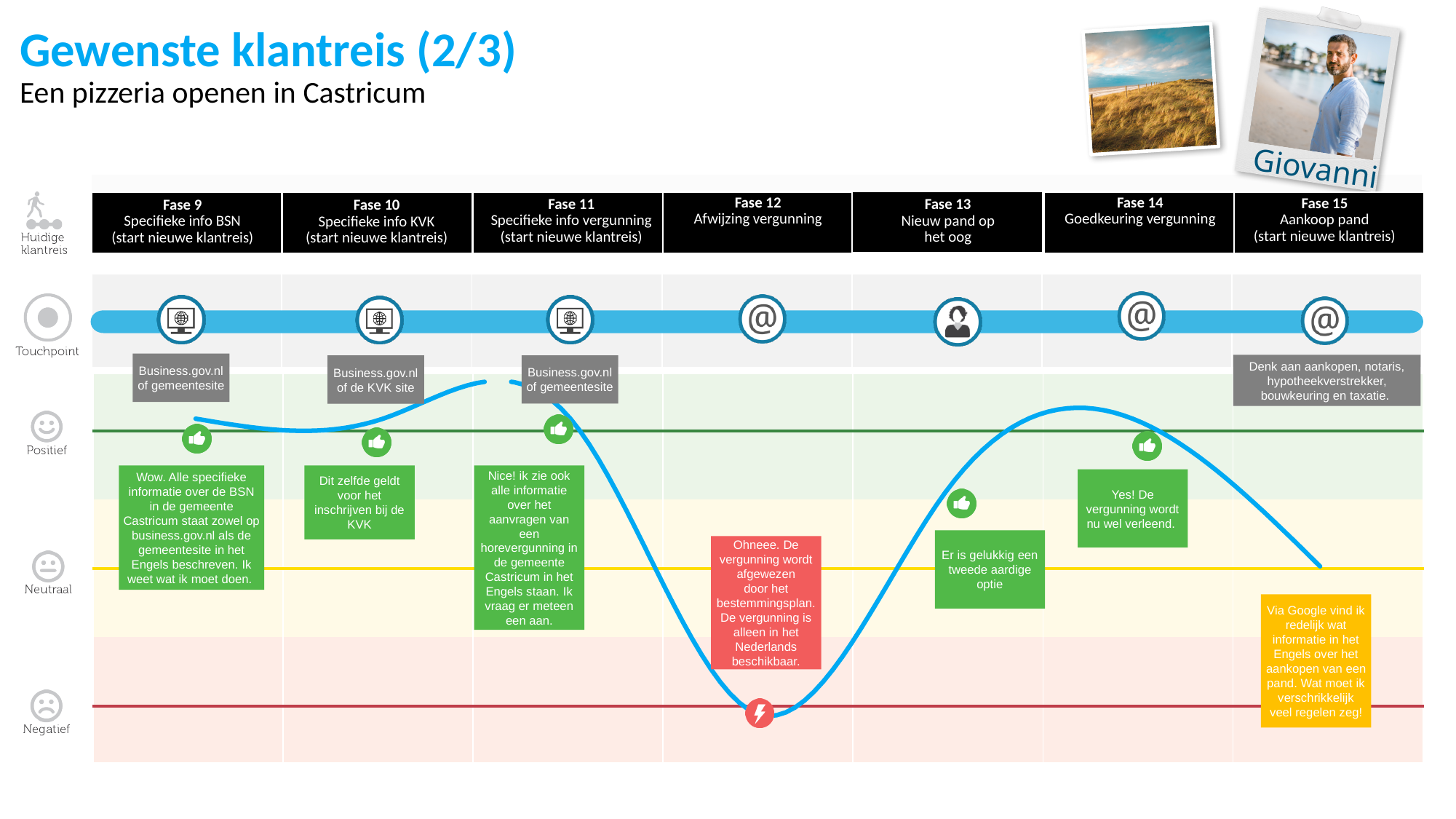
What is the title of the slide? Gewenste klantreis (2/3) Which phase has the higher position on the emotion curve, Fase 12 or Fase 14? Fase 14 Which phase is the first one shown on the journey map? Fase 9 How many phases (Fase) are shown across the top of the journey map? 7 How many emotion levels are labelled on the left side of the journey map? 3 Does the emotion curve rise or fall between Fase 11 and Fase 12? fall In which phase does the emotion curve reach its lowest point? Fase 12 Does the emotion curve rise or fall between Fase 14 and Fase 15? fall Which phase is the last one shown on the journey map? Fase 15 Which phase is titled 'Afwijzing vergunning'? Fase 12 Does the emotion curve rise or fall between Fase 12 and Fase 14? rise